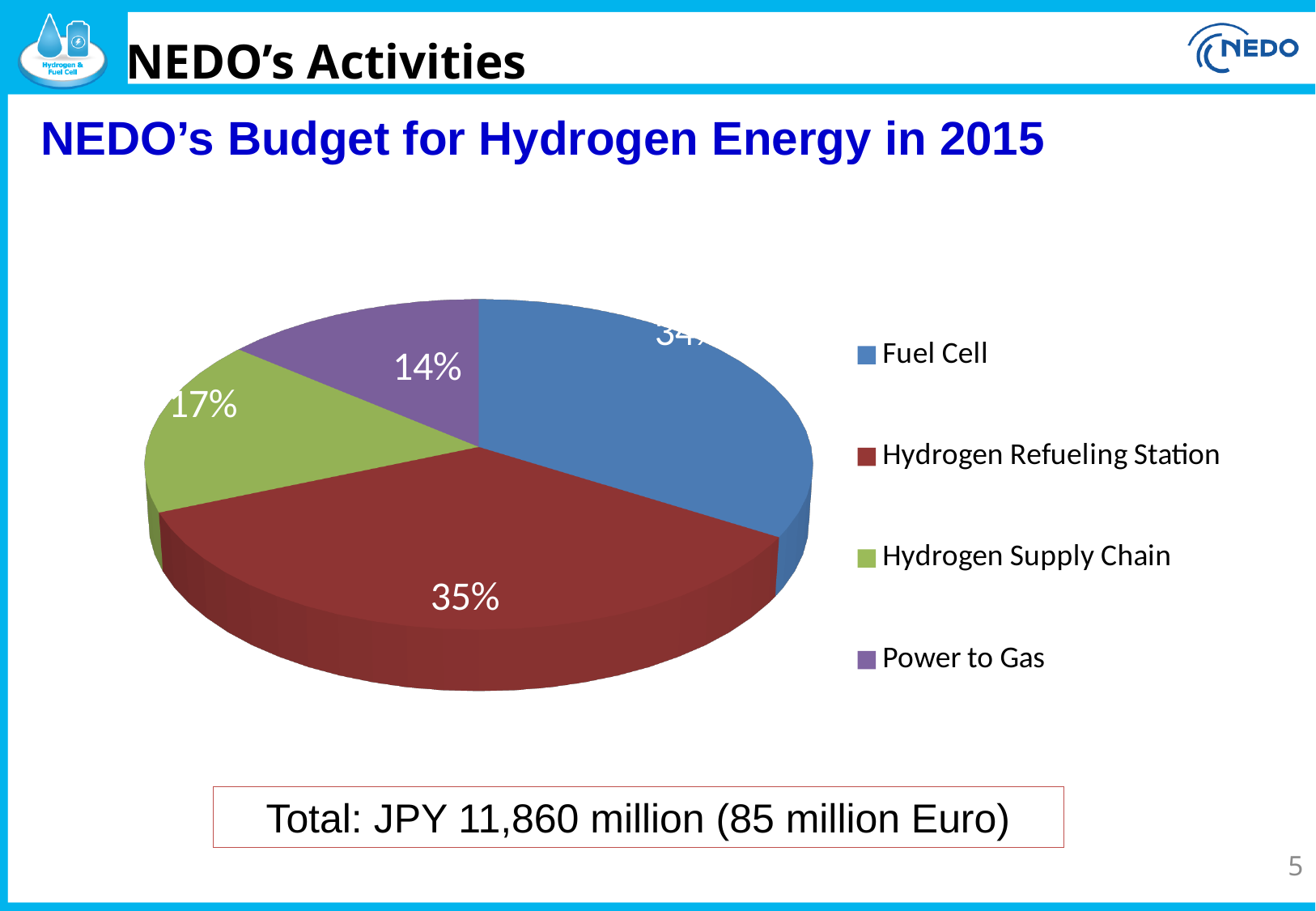
What colour represents Hydrogen Refueling Station in the pie chart? Red What is the difference in percentage points between Hydrogen Supply Chain and Power to Gas? 3 percentage points How many entries does the legend list? 4 What share of the budget goes to Hydrogen Refueling Station? 35% What is the title of the chart? NEDO's Budget for Hydrogen Energy in 2015 Which is larger, the share for Hydrogen Supply Chain or the share for Power to Gas? Hydrogen Supply Chain How many categories does the pie chart show? 4 What share of the budget goes to Hydrogen Supply Chain? 17% What kind of chart is shown on the slide? Pie chart Which category has the smallest share of the pie? Power to Gas What share of the budget goes to Power to Gas? 14% What is the difference in percentage points between Hydrogen Refueling Station and Power to Gas? 21 percentage points